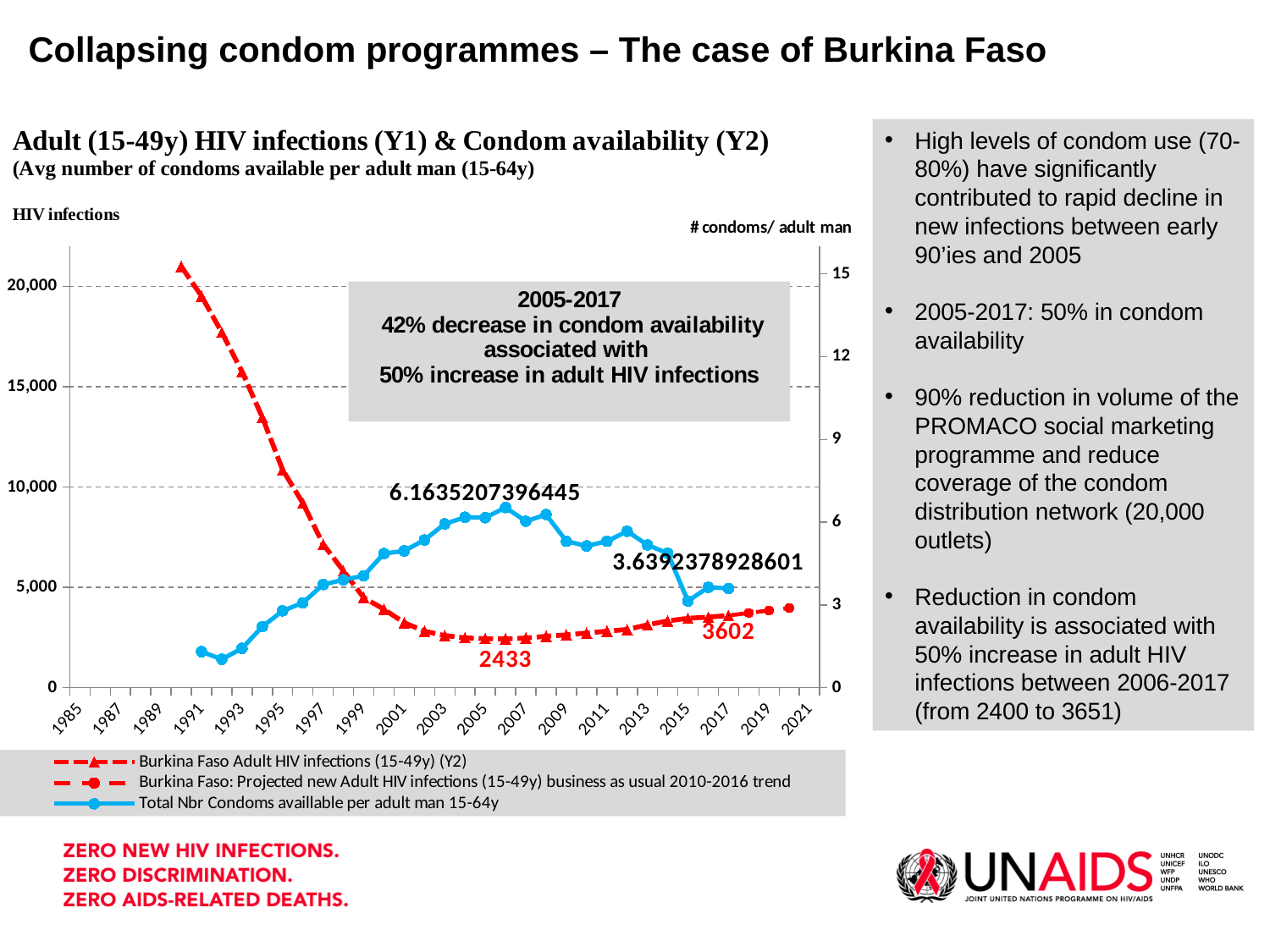
What is the label of the right-hand (secondary) y axis? # condoms/ adult man How many series does the chart legend list? 3 Is the value for adult HIV infections in 1990 greater or less than 20,000? greater Which is larger: the labelled adult HIV infections value around 2017 or the one around 2005? around 2017 (3602) What kind of chart is shown on the slide? line chart What is the labelled value of Burkina Faso adult HIV infections at its lowest point around 2005? 2433 What is the difference between the labelled HIV infection values 3602 and 2433? 1169 Is the value for condoms available per adult man in 2011 greater or less than 6? less What is the labelled peak value of total condoms available per adult man? 6.1635207396445 Do adult HIV infections rise or fall between 1990 and 2005? fall What is the labelled value of adult HIV infections around 2017? 3602 What is the labelled value of condoms available per adult man around 2017? 3.6392378928601